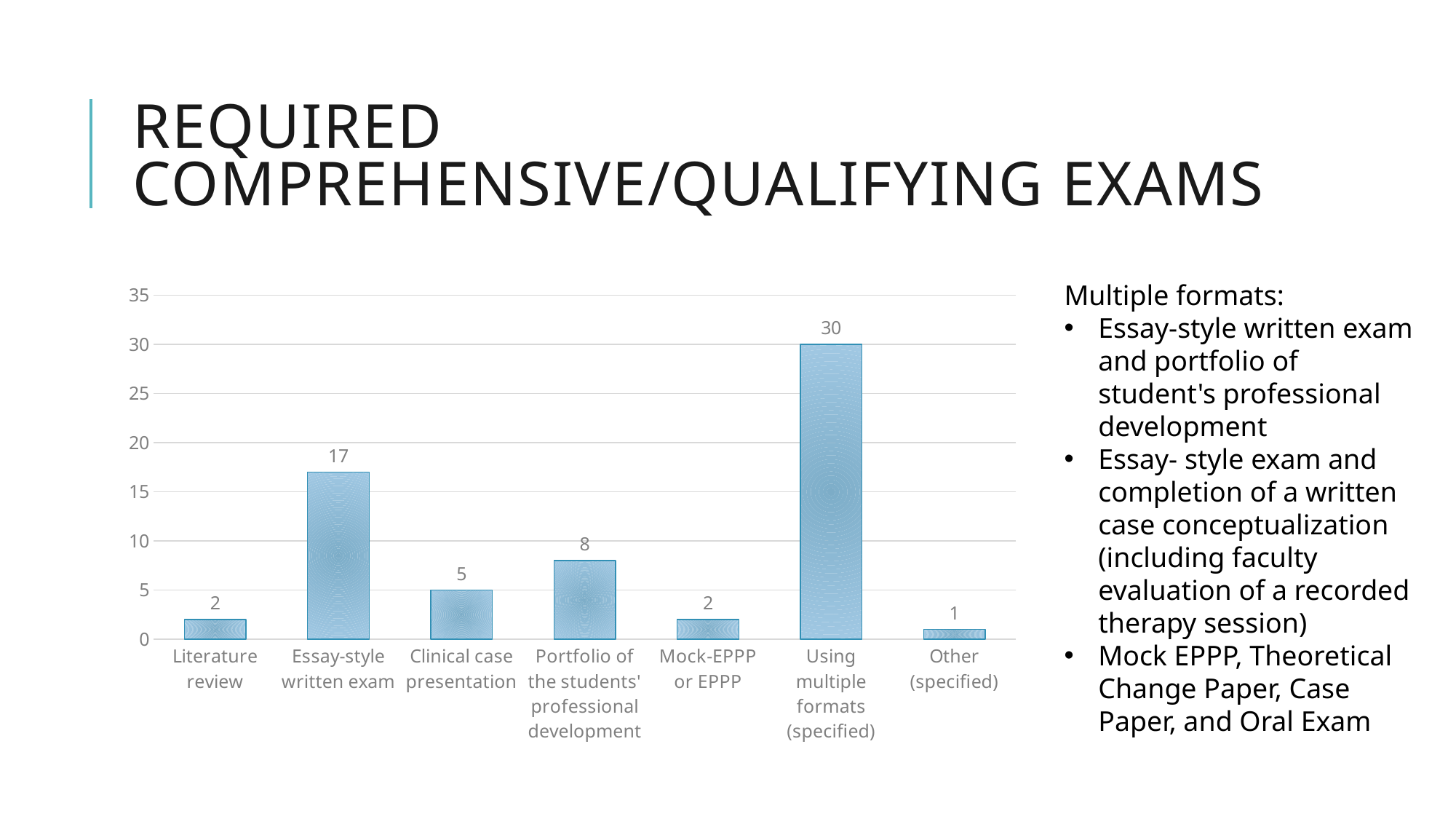
What is the difference between the values for Using multiple formats (specified) and Essay-style written exam? 13 What is the difference between the values for Mock-EPPP or EPPP and Other (specified)? 1 What kind of chart is shown on the slide? bar chart Which category has the lowest value? Other (specified) Which is larger, the value for Clinical case presentation or the value for Portfolio of the students' professional development? Portfolio of the students' professional development What is the value for Clinical case presentation? 5 Is the value for Essay-style written exam greater or less than 20? less What is the value for Using multiple formats (specified)? 30 What is the value for Portfolio of the students' professional development? 8 How many categories are shown on the x axis? 7 What is the value for Essay-style written exam? 17 Which category has the highest value? Using multiple formats (specified)